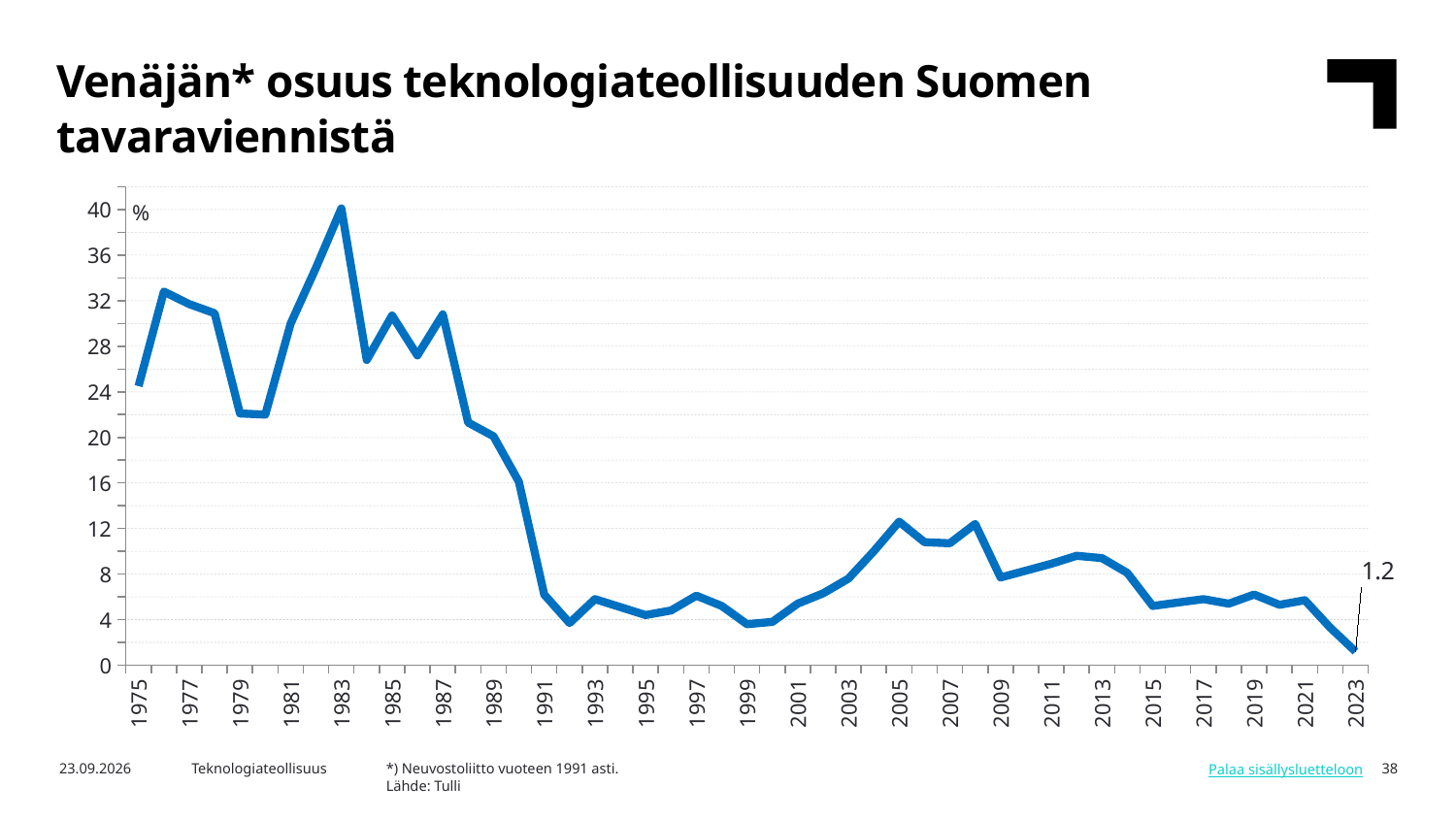
In which year does the line reach its lowest value? 2023 Is the value for 1975 greater or less than 20? greater Which year has the larger value, 1983 or 2005? 1983 Is the value for 2015 greater or less than 8? less What unit is shown at the top of the vertical axis? % Overall, does the line rise or fall from 1975 to 2023? fall Is the value for 2005 greater or less than 16? less In which year does the line reach its highest value? 1983 What value is labelled for the year 2023? 1.2 What kind of chart is shown on the slide? line chart Which year has the larger value, 1977 or 1997? 1977